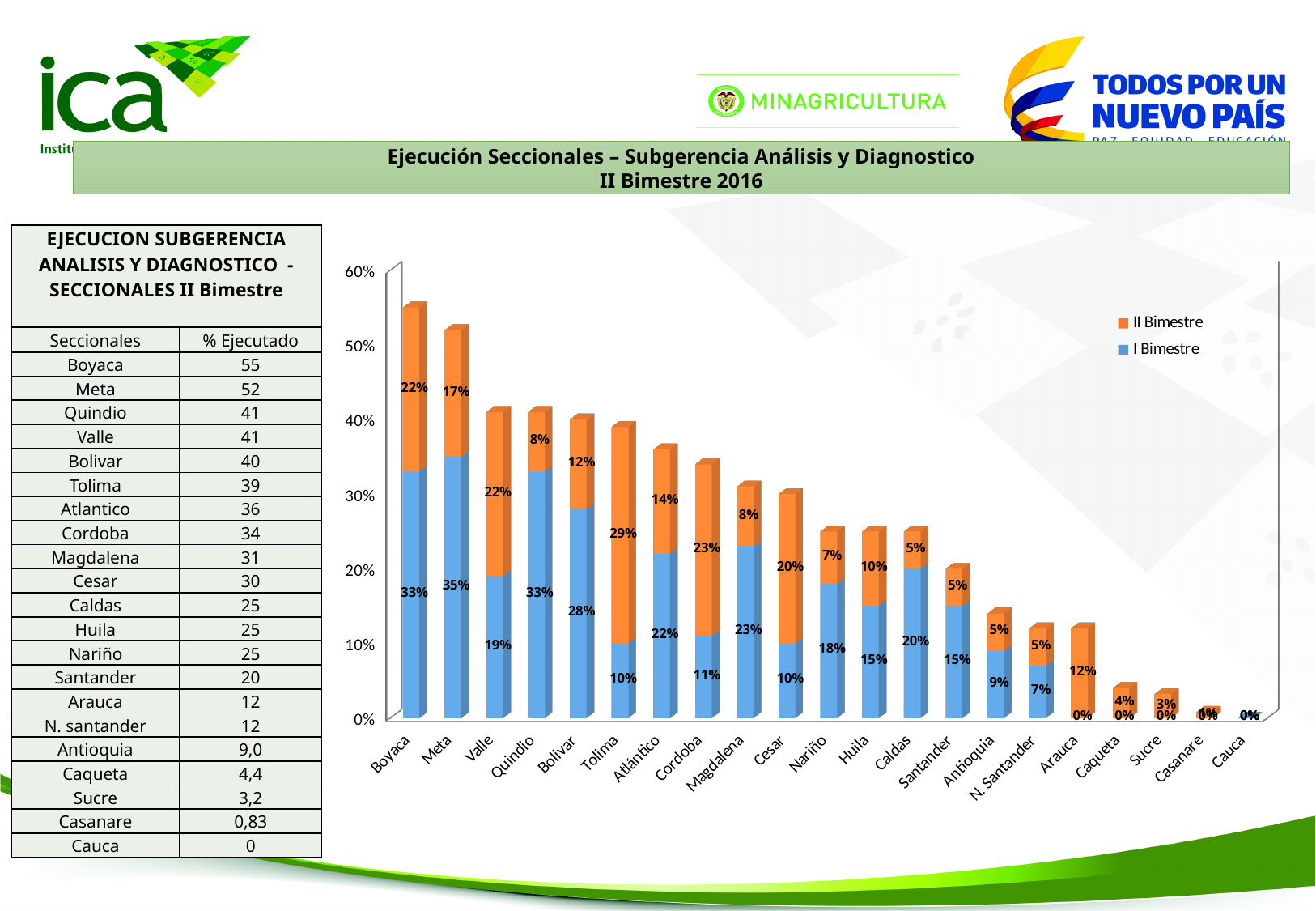
What is the I Bimestre value for Arauca in the chart? 0% Which seccional has the highest I Bimestre value in the chart? Meta What is the II Bimestre value for Tolima in the chart? 29% Which seccional has the highest II Bimestre value in the chart? Tolima How many seccionales (categories) are plotted on the x axis of the chart? 21 How many series does the chart legend list? 2 Which is larger for Cordoba: the I Bimestre value or the II Bimestre value? II Bimestre What is the total of the stacked bar for Boyaca (I Bimestre plus II Bimestre)? 55% Which colour represents the II Bimestre series in the chart? orange What is the I Bimestre value for Bolivar in the chart? 28% What kind of chart is shown on the slide? stacked bar chart What is the difference between the I Bimestre values for Meta and Valle? 16%